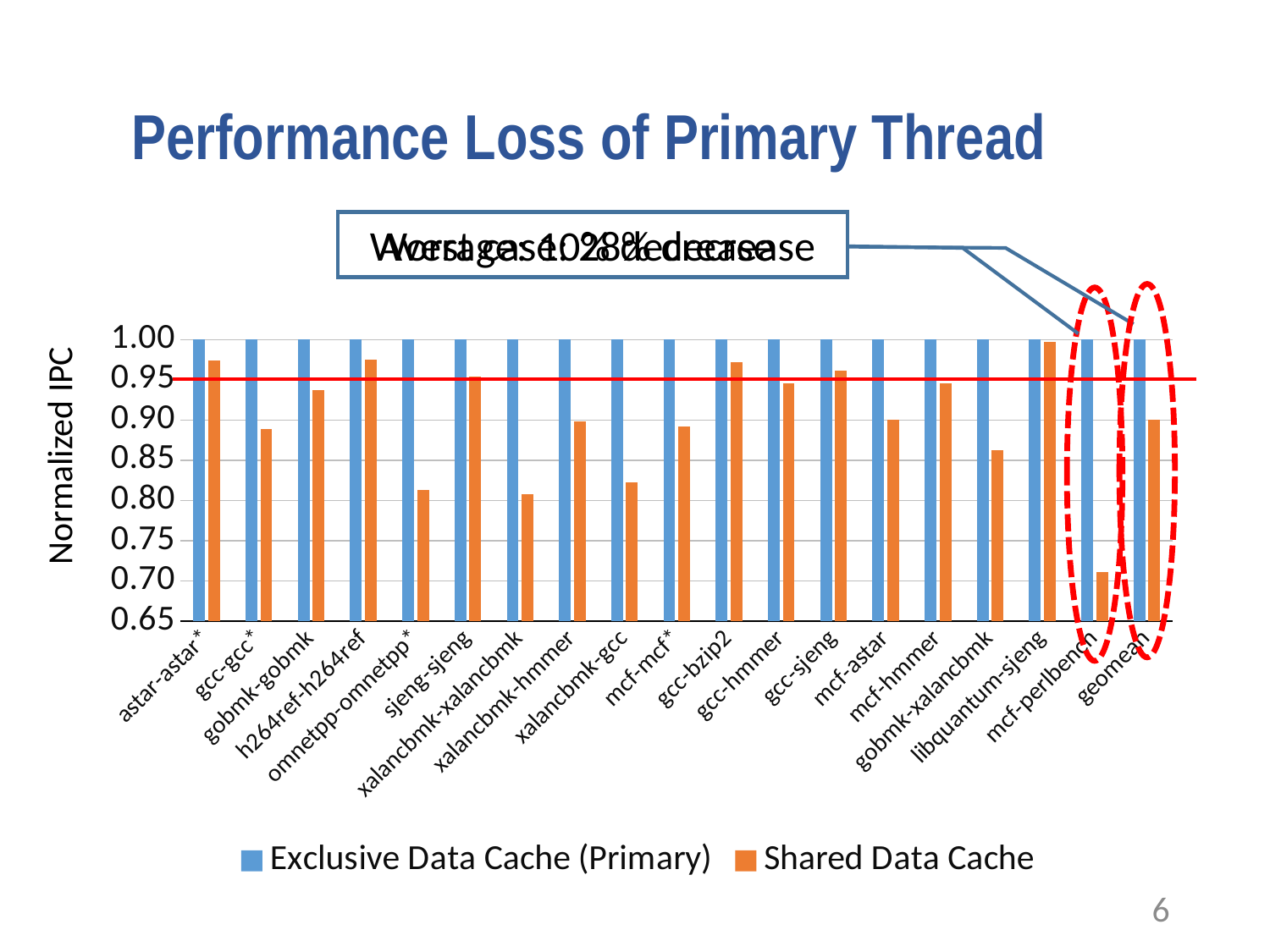
How many categories are shown along the x axis? 19 Is the Shared Data Cache value for mcf-perlbench greater or less than 0.75? less What is the label of the y axis? Normalized IPC Is the Shared Data Cache value for xalancbmk-xalancbmk greater or less than 0.85? less Which is larger, the Shared Data Cache value for astar-astar* or for mcf-perlbench? astar-astar* How many series does the legend list? 2 What kind of chart is shown on the slide? bar chart Which category has the highest Shared Data Cache value? libquantum-sjeng What is the Exclusive Data Cache (Primary) value for gcc-bzip2? 1.00 Which colour represents the Shared Data Cache series? orange Is the Shared Data Cache value for astar-astar* greater or less than 0.95? greater Which category has the lowest Shared Data Cache value? mcf-perlbench